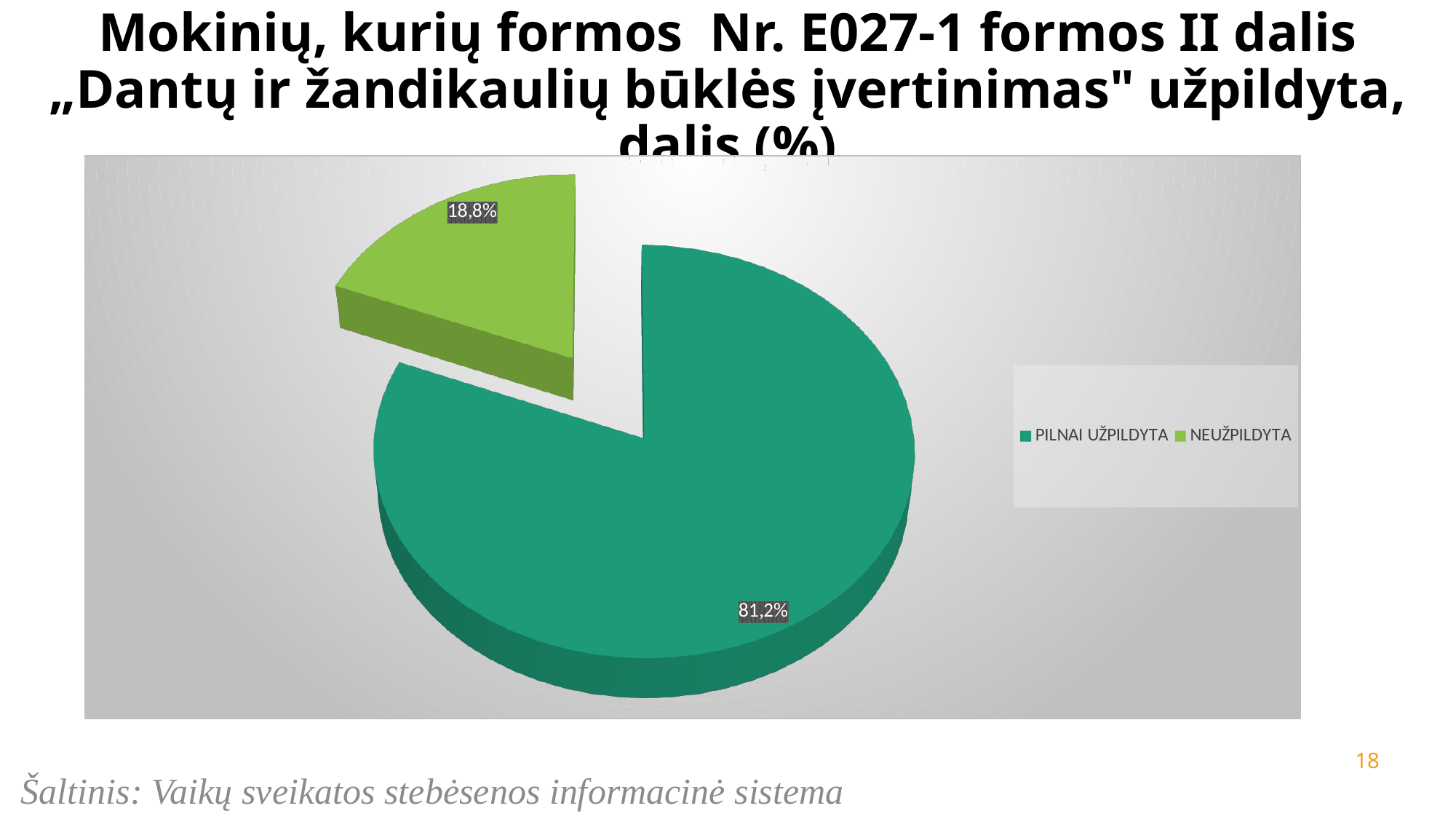
Which slice is pulled out (exploded) from the pie? NEUŽPILDYTA What colour is the NEUŽPILDYTA slice? light green What is the difference in percentage points between the PILNAI UŽPILDYTA and NEUŽPILDYTA slices? 62,4 How many slices does the pie chart have? 2 What share of the pie is labelled NEUŽPILDYTA? 18,8% Which slice of the pie is the largest? PILNAI UŽPILDYTA What share of the pie is labelled PILNAI UŽPILDYTA? 81,2% What kind of chart is shown on the slide? pie chart Which slice of the pie is the smallest? NEUŽPILDYTA Which is larger, the PILNAI UŽPILDYTA slice or the NEUŽPILDYTA slice? PILNAI UŽPILDYTA How many entries does the legend list? 2